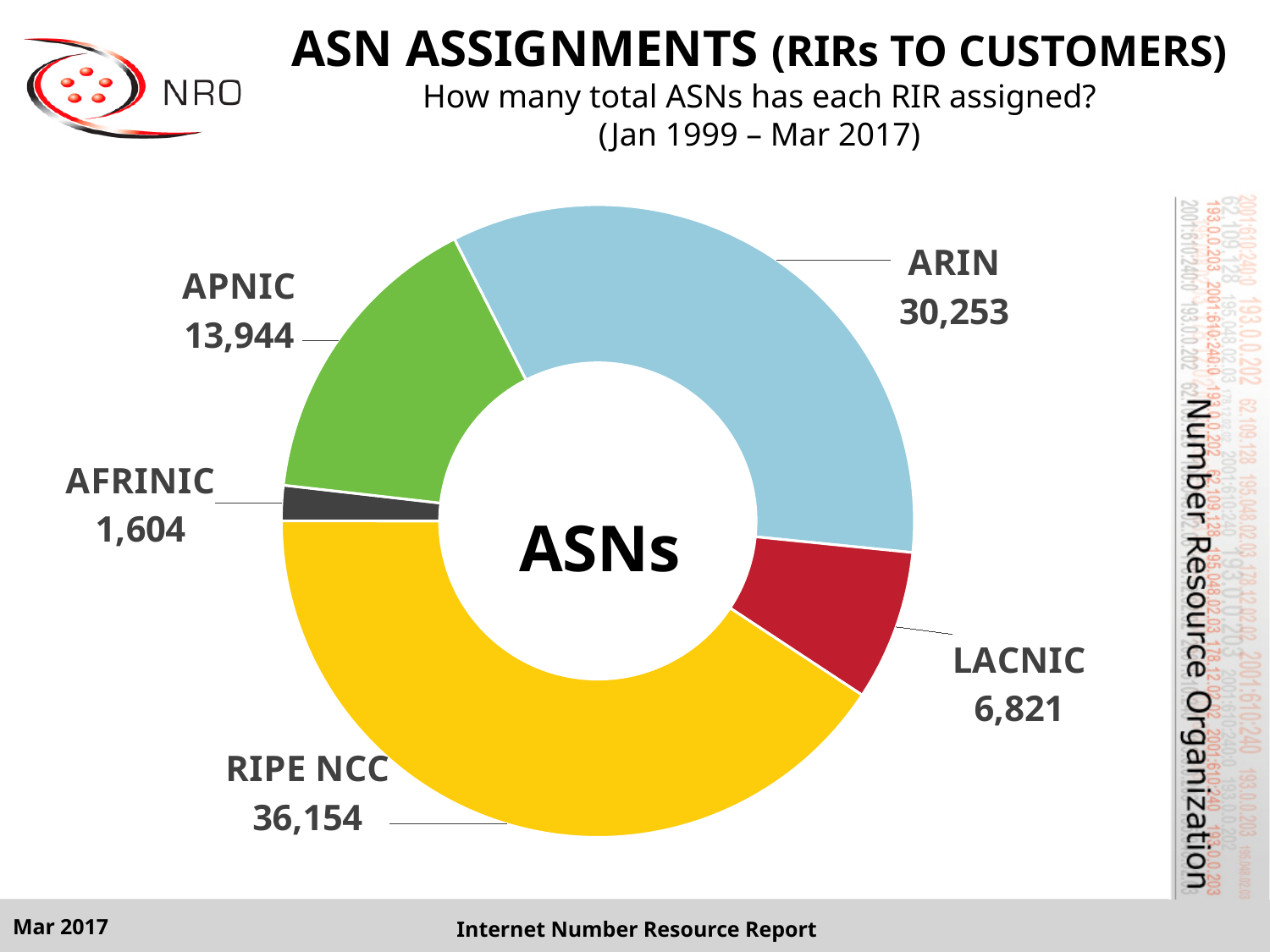
How many ASNs has AFRINIC assigned? 1,604 How many ASNs has ARIN assigned according to the chart? 30,253 Which RIR has assigned the most ASNs? RIPE NCC Which has assigned more ASNs, APNIC or LACNIC? APNIC What is the difference between the APNIC and LACNIC values? 7,123 Which RIR has assigned the fewest ASNs? AFRINIC What value is shown for LACNIC? 6,821 What is the value shown for RIPE NCC? 36,154 How many RIRs are shown in the chart? 5 How many more ASNs has RIPE NCC assigned than ARIN? 5,901 What is the total number of ASNs assigned across all five RIRs shown? 88,776 What kind of chart is shown on the slide? doughnut chart